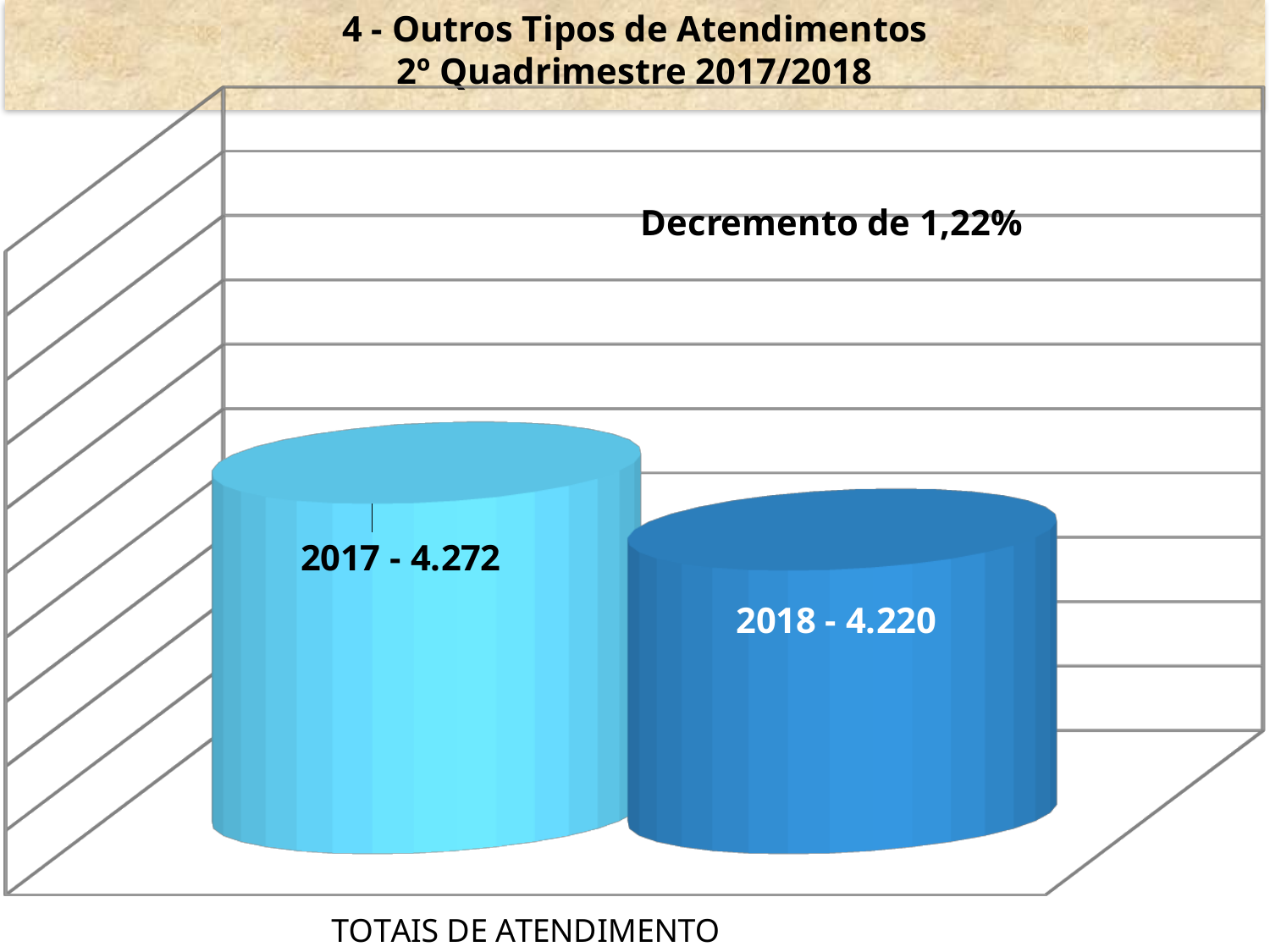
How many bars are plotted on the chart? 2 What is the value for 2018? 4.220 Is the value for 2018 larger or smaller than the value for 2017? smaller Which year has the higher value? 2017 What is the difference between the 2017 value and the 2018 value? 52 What percentage decrease is stated on the chart? 1,22% What is the title of the chart? 4 - Outros Tipos de Atendimentos 2º Quadrimestre 2017/2018 What is the value for 2017? 4.272 Which year has the lower value? 2018 Do the values rise or fall from 2017 to 2018? fall What kind of chart is shown on the slide? bar chart